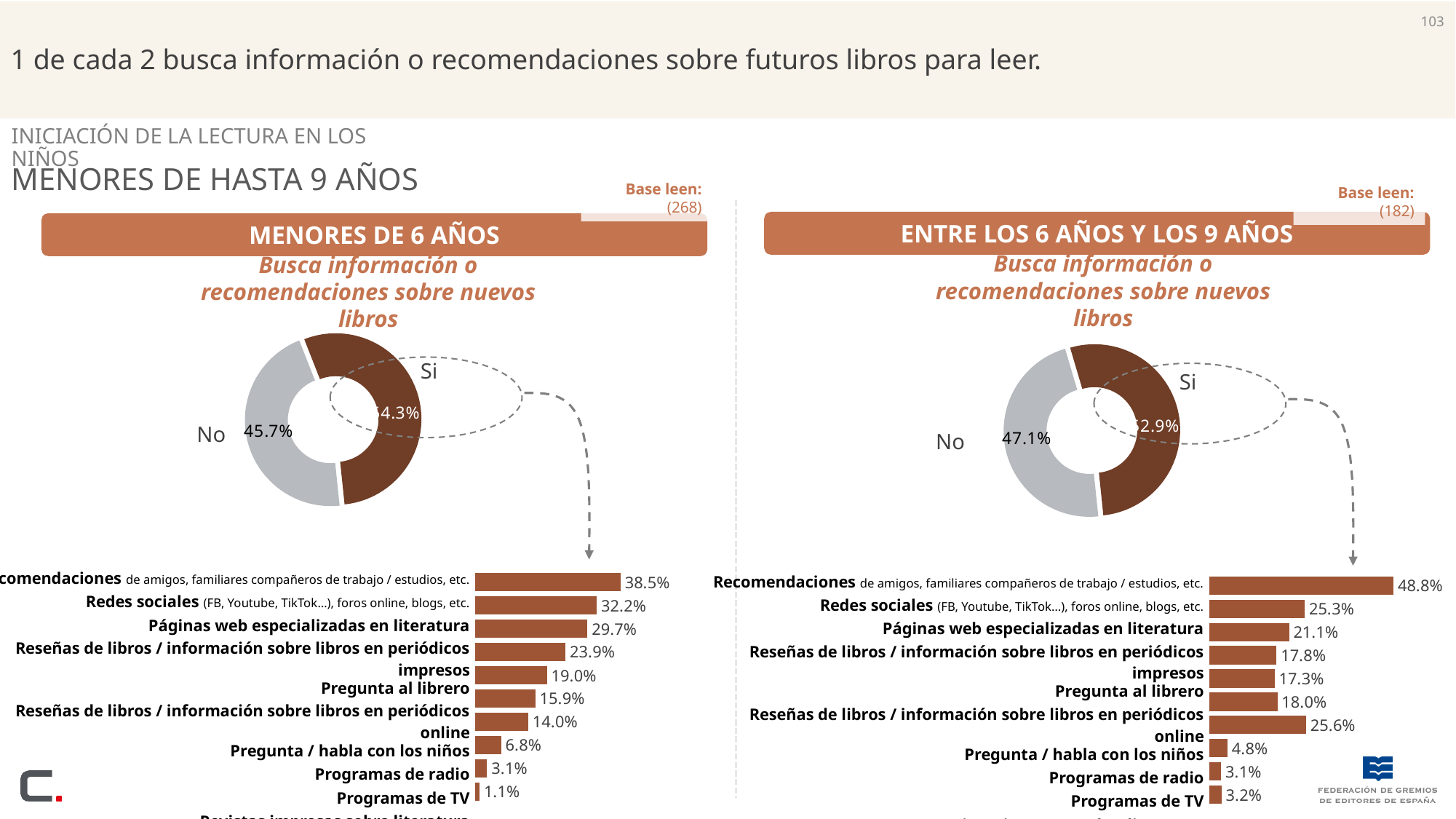
In the 'Entre los 6 años y los 9 años' bar chart, what is the value for 'Recomendaciones de amigos, familiares compañeros de trabajo / estudios, etc.'? 48.8% In the 'Entre los 6 años y los 9 años' donut chart, what percentage answered 'No'? 47.1% What is the difference between the 'Recomendaciones' value in the 'Entre los 6 años y los 9 años' bar chart and the 'Recomendaciones' value in the 'Menores de 6 años' bar chart? 10.3 percentage points Is the 'Redes sociales' value larger in the 'Menores de 6 años' bar chart or in the 'Entre los 6 años y los 9 años' bar chart? Menores de 6 años In the 'Menores de 6 años' bar chart, what is the value for 'Recomendaciones de amigos, familiares compañeros de trabajo / estudios, etc.'? 38.5% In the 'Entre los 6 años y los 9 años' bar chart, which category has the highest value? Recomendaciones de amigos, familiares compañeros de trabajo / estudios, etc. In the 'Entre los 6 años y los 9 años' bar chart, what is the value for 'Páginas web especializadas en literatura'? 21.1% In the 'Menores de 6 años' bar chart, what is the value for 'Redes sociales'? 32.2% What kind of chart is used to show the 'Si' / 'No' split under 'Menores de 6 años'? Donut (pie) chart In the 'Menores de 6 años' bar chart, which category has the highest value? Recomendaciones de amigos, familiares compañeros de trabajo / estudios, etc. How many bars are shown in the 'Menores de 6 años' bar chart? 10 In the 'Menores de 6 años' donut chart, what percentage answered 'No'? 45.7%